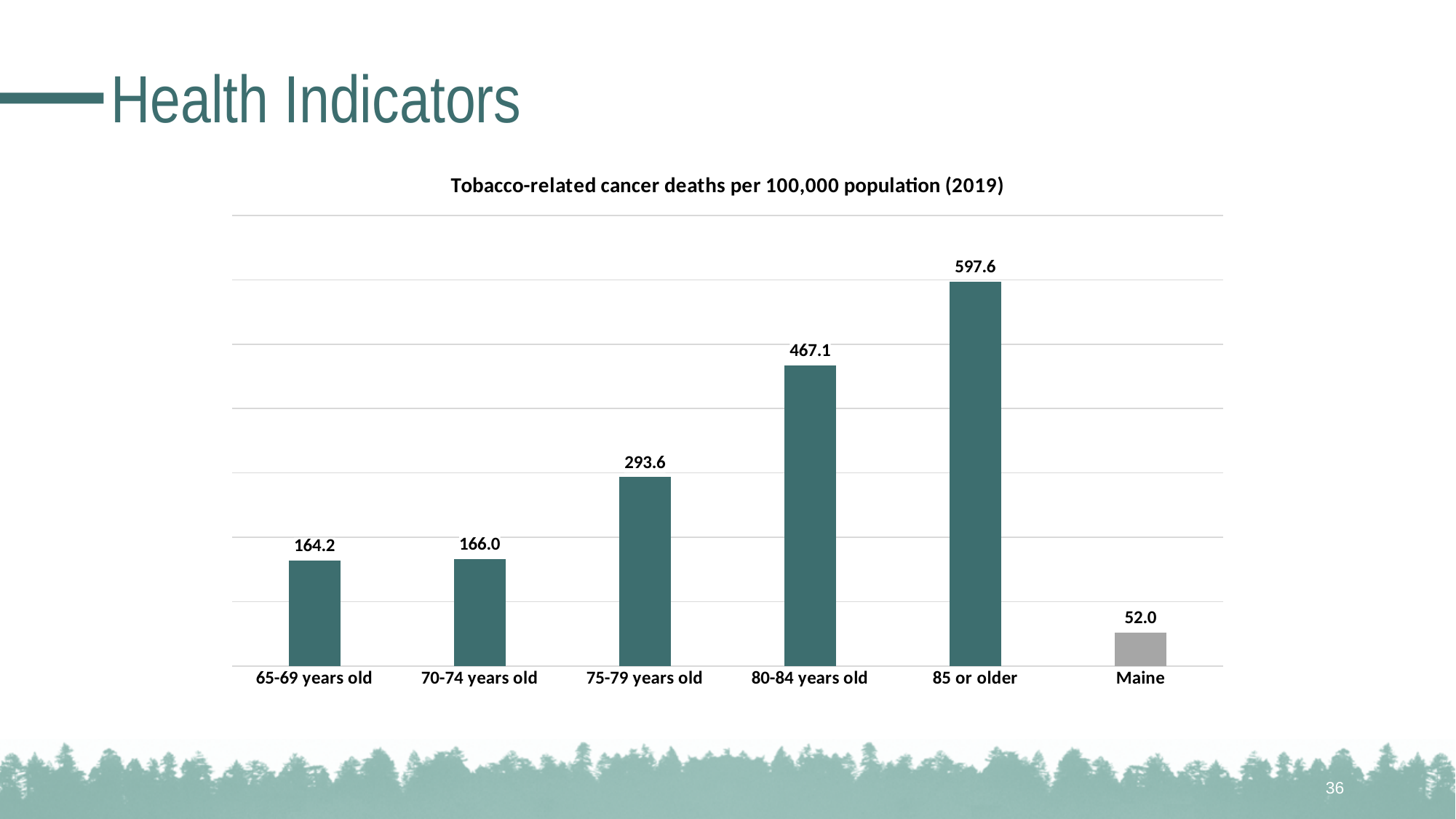
What kind of chart is this? bar chart What is the value for 65-69 years old? 164.2 Which is larger, the value for 80-84 years old or the value for 75-79 years old? 80-84 years old What is the difference between the values for 85 or older and 80-84 years old? 130.5 Which category has the lowest value? Maine What is the value for 75-79 years old? 293.6 Which category has the highest value? 85 or older What is the value for Maine? 52.0 How many categories are shown on the x axis? 6 What is the difference between the values for 75-79 years old and Maine? 241.6 What is the title of the chart? Tobacco-related cancer deaths per 100,000 population (2019) What is the value for 85 or older? 597.6